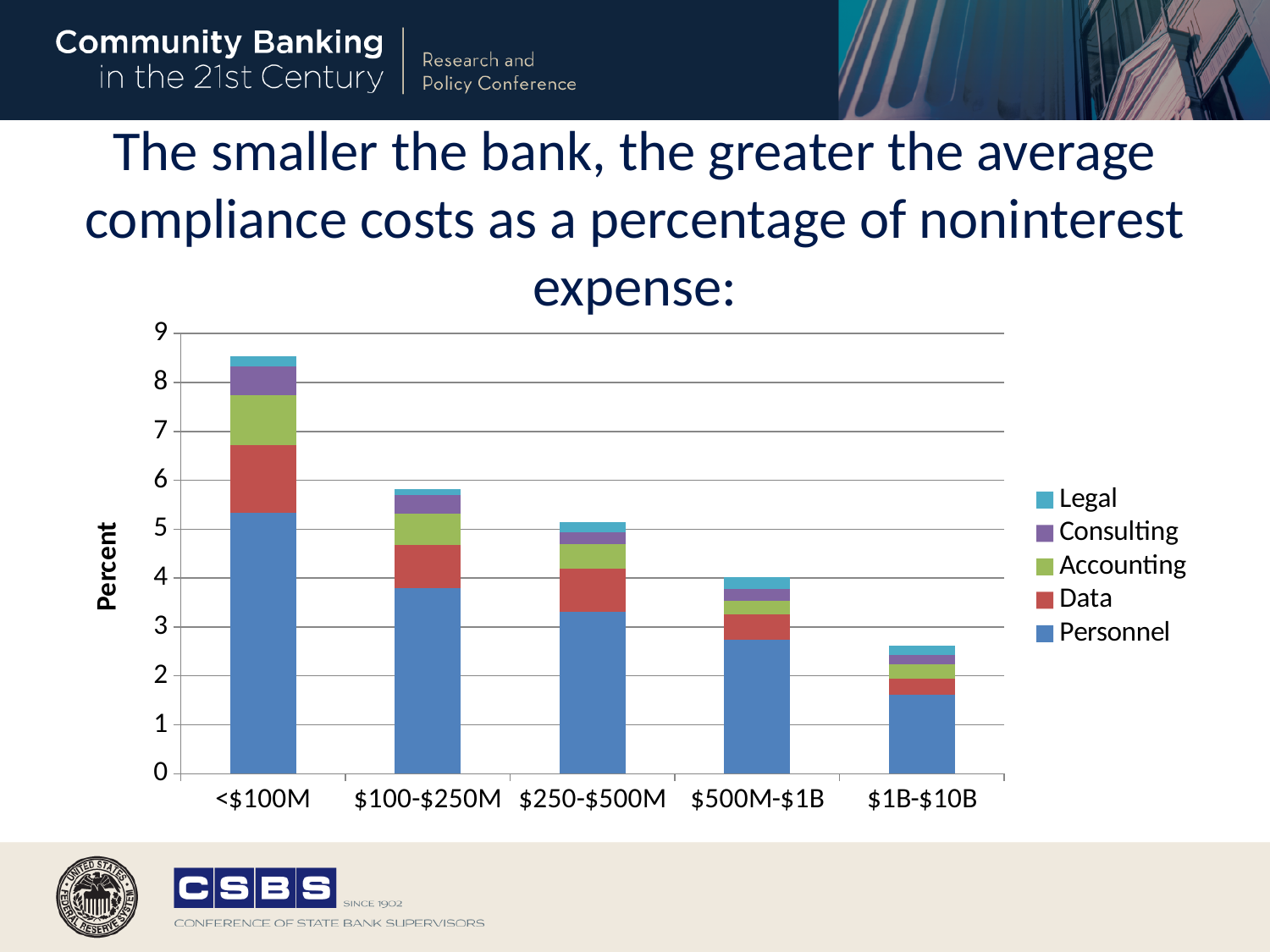
What kind of chart is shown on the slide? Stacked bar chart How many bank size categories are shown on the x axis? 5 What is the label on the y axis? Percent Is the total value for $100-$250M greater or less than 5? greater Which has a larger Personnel value, $250-$500M or $500M-$1B? $250-$500M Is the Personnel value for $1B-$10B greater or less than 2? less How many series does the legend list? 5 Is the total value for $1B-$10B greater or less than 3? less Which bank size category has the lowest total compliance cost as a percentage of noninterest expense? $1B-$10B Do the total bar heights rise or fall as bank size increases along the x axis? Fall Which bank size category has the highest total compliance cost as a percentage of noninterest expense? <$100M